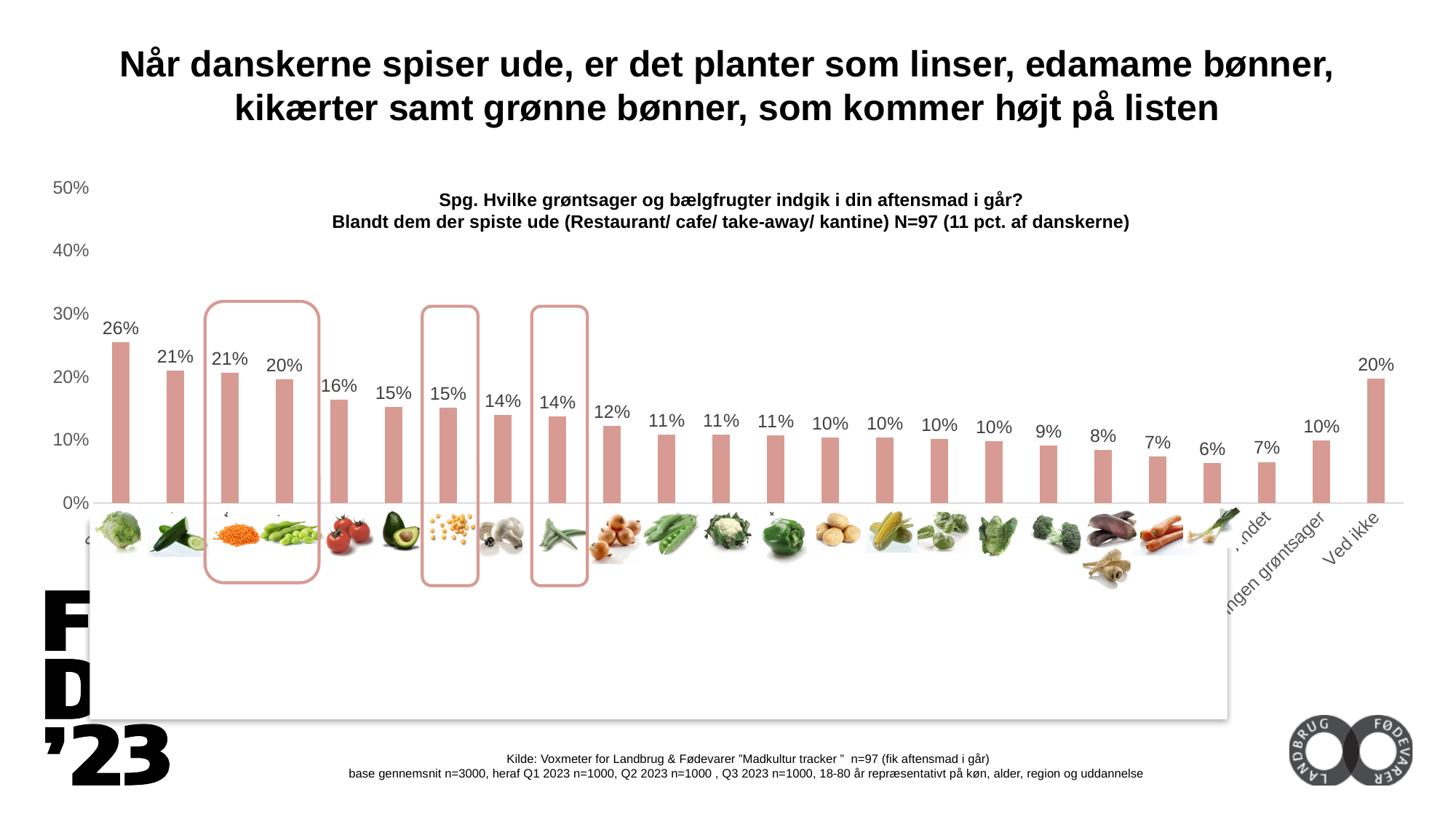
How many percentage points higher is "Ved ikke" than "Ingen grøntsager"? 10 percentage points What is the highest value shown on the vertical axis of the chart? 50% What kind of chart is shown on the slide? Bar chart What is the lowest value shown on any bar in the chart? 6% Which has the larger value, "Ved ikke" or "Ingen grøntsager"? Ved ikke According to the chart subtitle, what is the sample size N for those who ate out? N=97 What is the highest value shown on any bar in the chart? 26% How many bars are plotted in the chart? 24 What is the value for "Ved ikke"? 20% Is the value for "Ved ikke" greater or less than 10%? greater What is the value for "Ingen grøntsager"? 10%